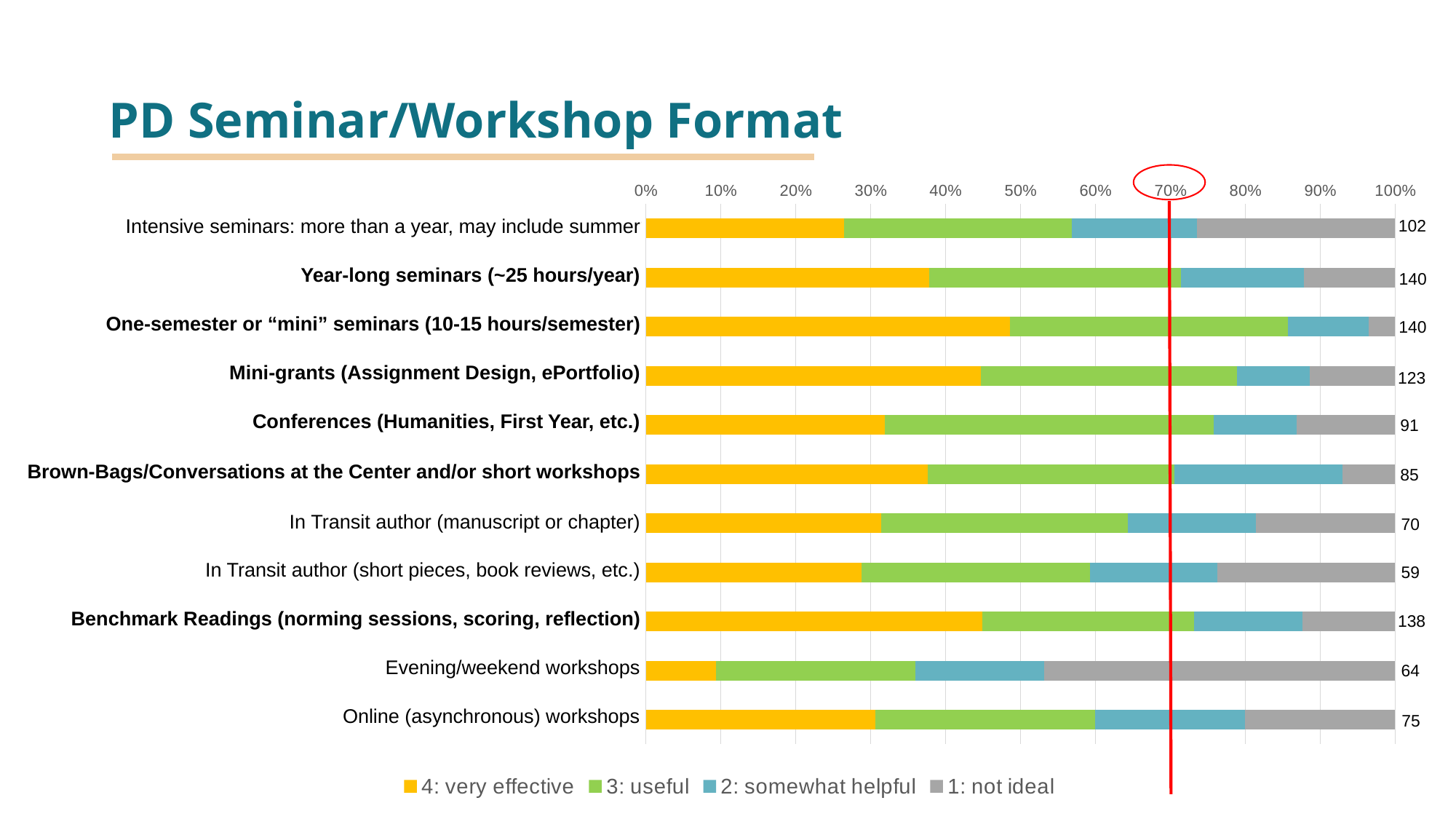
What number is printed at the end of the bar for Evening/weekend workshops? 64 What kind of chart is shown on the slide? Stacked bar chart Is the '4: very effective' share for Intensive seminars: more than a year, may include summer greater or less than 30%? less Which has a larger share of '1: not ideal' responses: Evening/weekend workshops or Online (asynchronous) workshops? Evening/weekend workshops How many PD formats (categories) are plotted in the chart? 11 What number is printed at the end of the bar for Year-long seminars (~25 hours/year)? 140 What number is printed at the end of the bar for In Transit author (short pieces, book reviews, etc.)? 59 Which category has the largest share of '4: very effective' responses? One-semester or "mini" seminars (10-15 hours/semester) Which category has the smallest share of '4: very effective' responses? Evening/weekend workshops Is the '4: very effective' share for Mini-grants (Assignment Design, ePortfolio) greater or less than 40%? greater How many series does the legend list? 4 What is the difference between the numbers printed for One-semester or "mini" seminars (10-15 hours/semester) and In Transit author (short pieces, book reviews, etc.)? 81